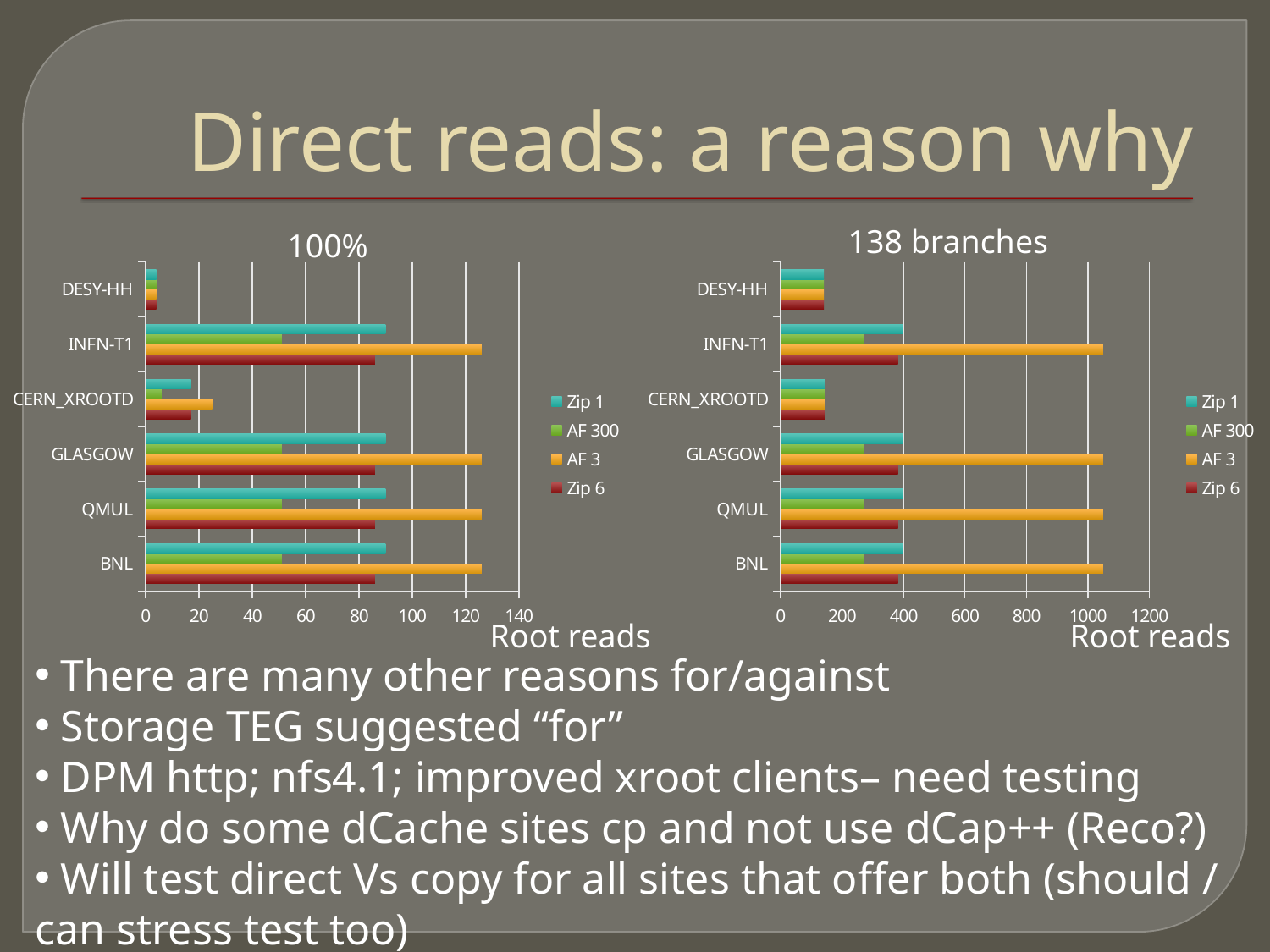
How many categories are shown on the y axis of the "100%" chart? 6 In the "138 branches" chart, is the Zip 6 value for DESY-HH greater or less than 200? less In the "100%" chart, is the AF 3 value for BNL greater or less than 120? greater How many series does the legend of the "138 branches" chart list? 4 What is the x-axis label of the "138 branches" chart? Root reads In the "100%" chart, which is larger for BNL, AF 3 or Zip 6? AF 3 In the "100%" chart, which series has the longest bar for INFN-T1? AF 3 In the "138 branches" chart, is the AF 300 value for BNL greater or less than 200? greater What kind of chart is the "100%" chart? bar chart